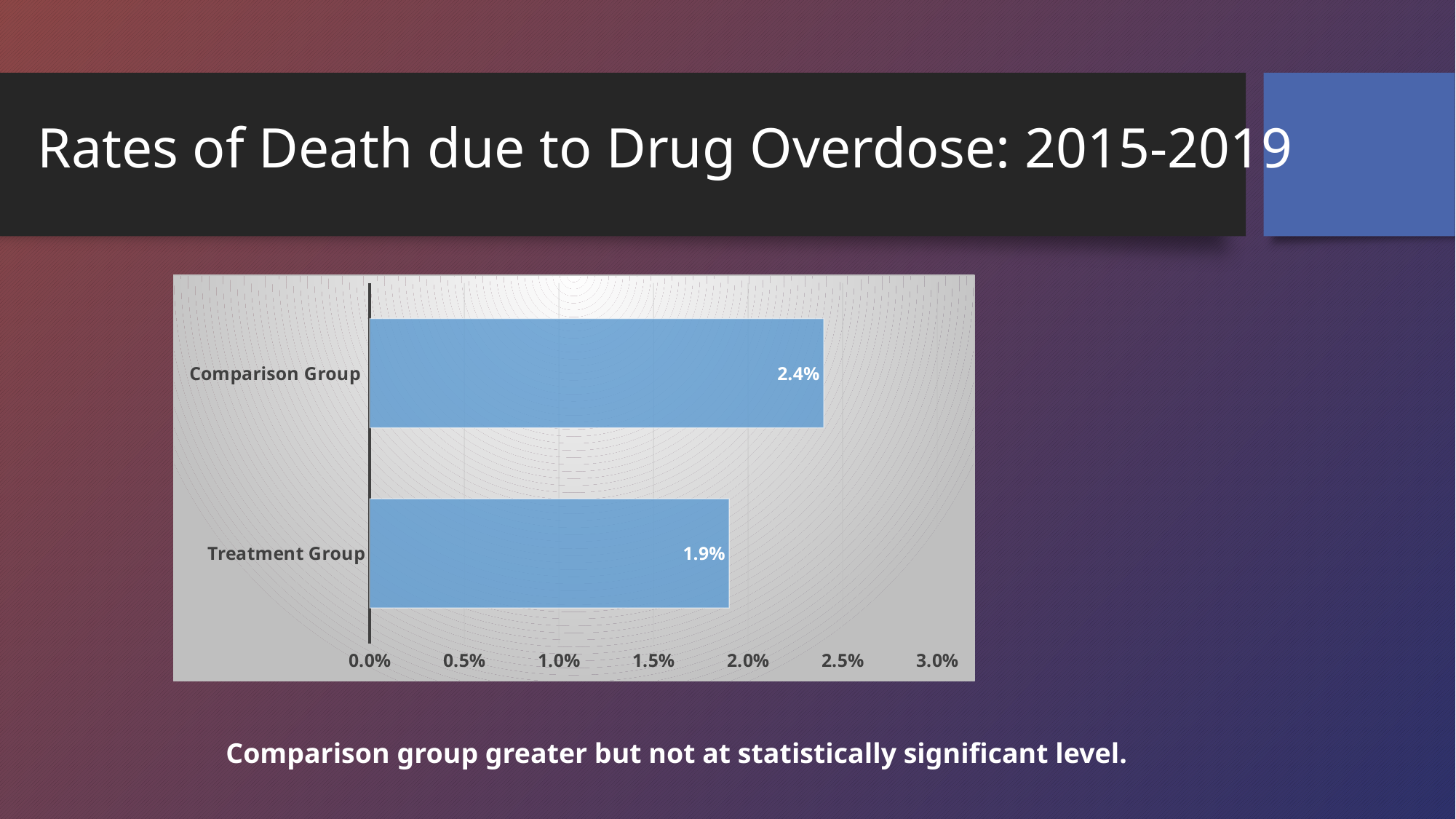
What kind of chart is shown on the slide? bar chart Is the value for the Treatment Group greater or less than 2.0%? less Is the death rate for the Comparison Group larger or smaller than that of the Treatment Group? larger How many groups are shown in the chart? 2 Is the value for the Comparison Group greater or less than 2.0%? greater Which group has the lower rate of death due to drug overdose? Treatment Group What is the maximum value shown on the horizontal axis of the chart? 3.0% What is the rate of death due to drug overdose for the Comparison Group? 2.4% Which group has the higher rate of death due to drug overdose? Comparison Group What is the rate of death due to drug overdose for the Treatment Group? 1.9% What is the title of the slide containing the chart? Rates of Death due to Drug Overdose: 2015-2019 What is the difference between the Comparison Group and Treatment Group death rates? 0.5%